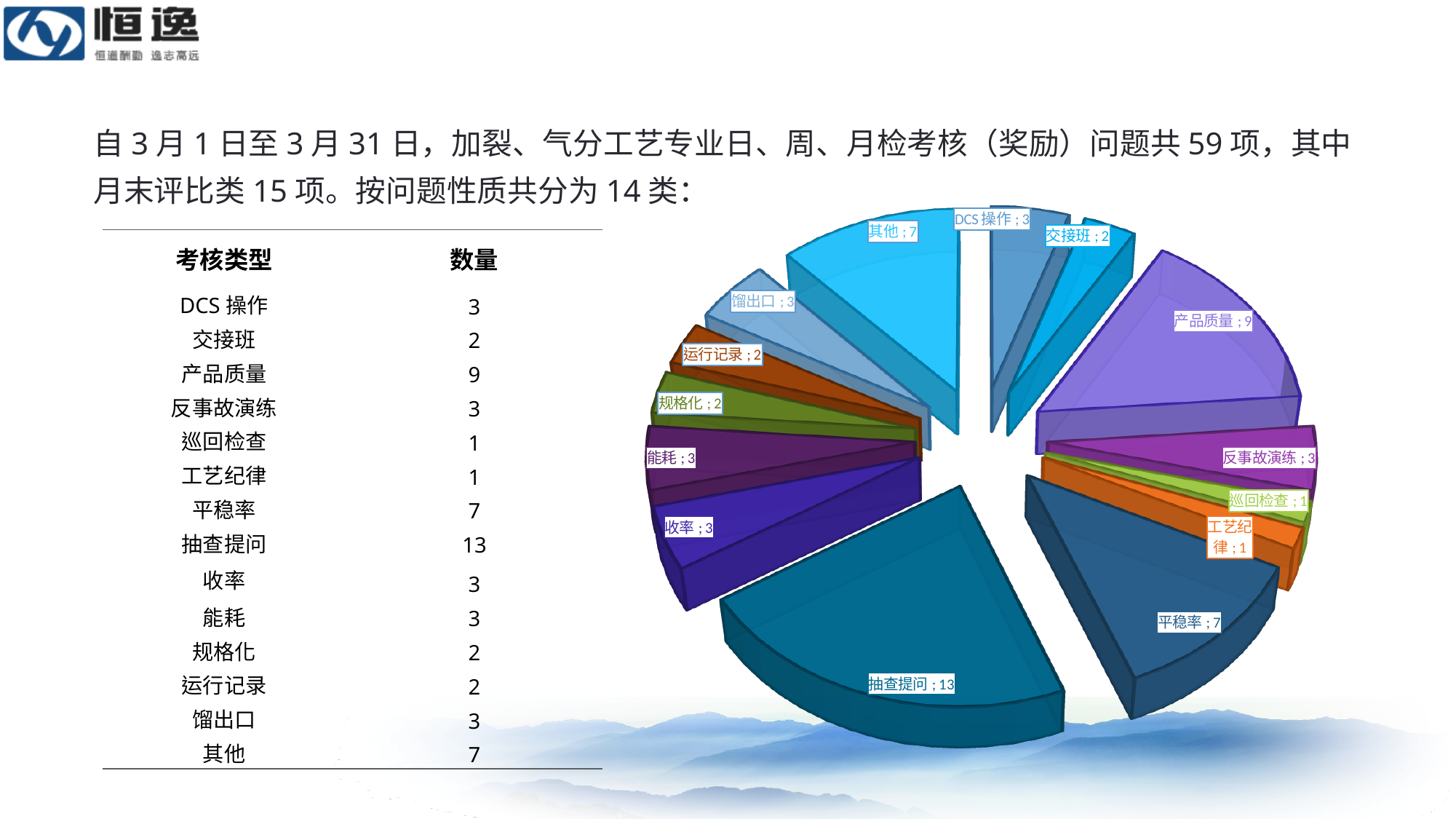
How many slices does the pie chart have? 14 What kind of chart is shown on the slide? pie chart What is the value for 产品质量 in the pie chart? 9 What is the value for 交接班 in the pie chart? 2 Which is larger in the pie chart, 平稳率 or 其他? They are equal (both 7) What is the difference between the values for 抽查提问 and 产品质量? 4 What is the value for 抽查提问 in the pie chart? 13 What is the total of all slice values in the pie chart? 59 Which category has the largest slice in the pie chart? 抽查提问 Which is larger in the pie chart, 产品质量 or 平稳率? 产品质量 What is the value for 馏出口 in the pie chart? 3 Which categories have the smallest value in the pie chart? 巡回检查 and 工艺纪律